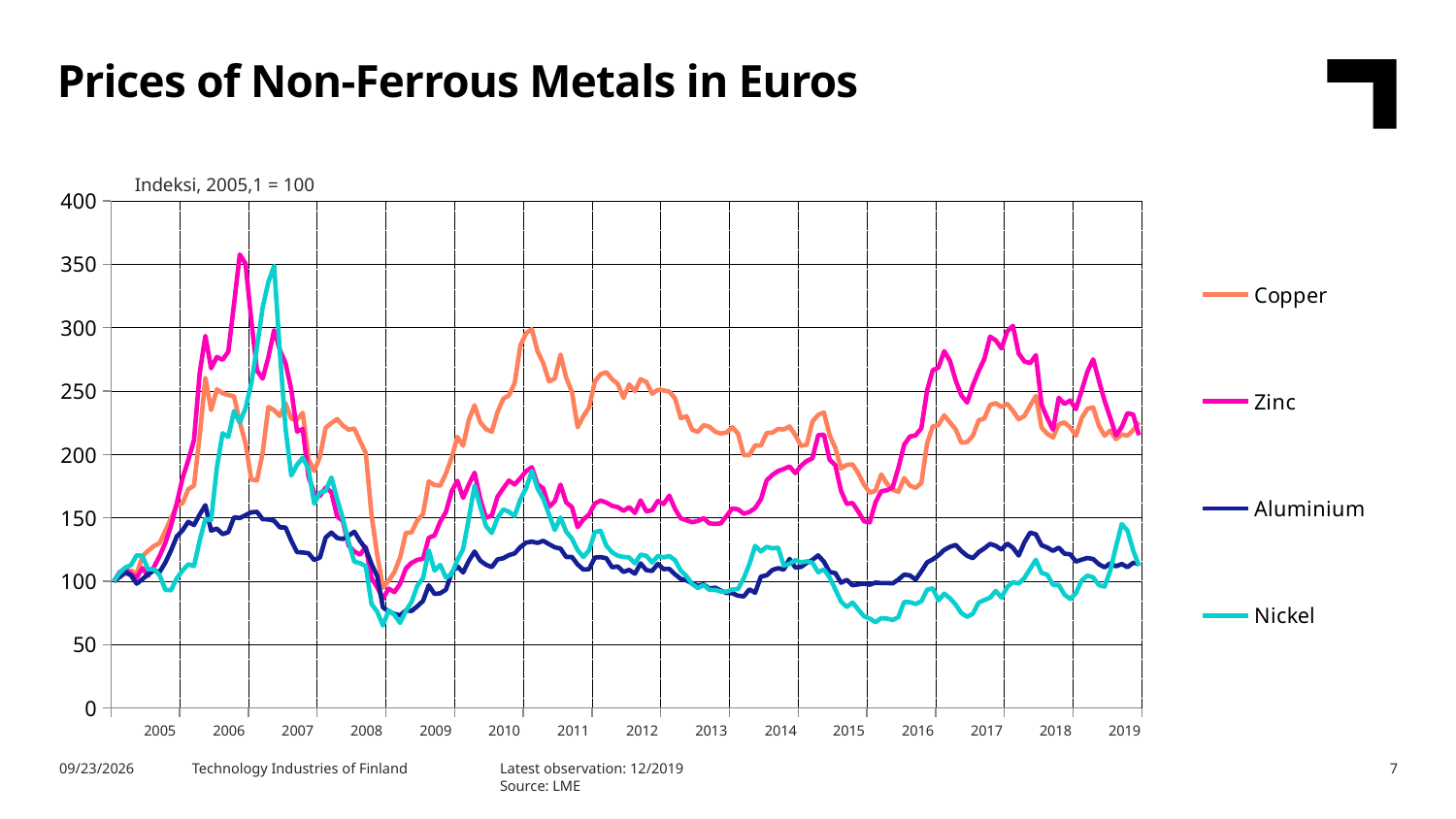
Which metals are listed in the chart legend? Copper, Zinc, Aluminium, Nickel What kind of chart is shown on the slide? Line chart Which series has the lowest peak value over the whole period? Aluminium Does the Nickel index rise or fall between 2007 and 2008? Fall Is the lowest value for Nickel in 2015 greater or less than 100? less How many series does the legend list? 4 What is the title of the chart on the slide? Prices of Non-Ferrous Metals in Euros Is the highest value reached by Aluminium greater or less than 200? less Is the peak value for Nickel in 2006 greater or less than 300? less At the end of 2019, which is higher, Copper or Aluminium? Copper